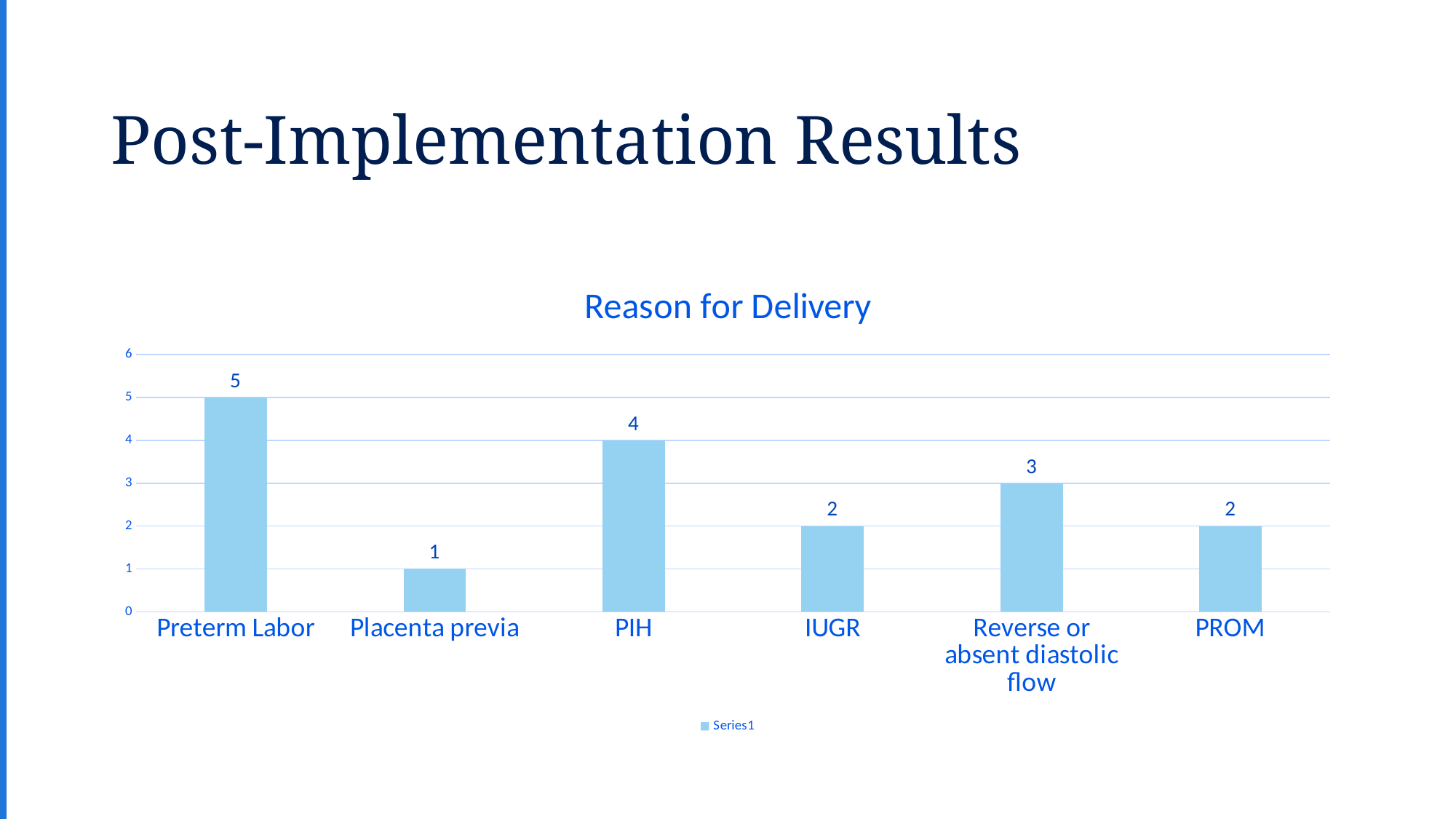
What is the difference between the values for PIH and IUGR? 2 What is the difference between the values for Preterm Labor and Placenta previa? 4 What is the value for Reverse or absent diastolic flow? 3 Which is larger, the value for PIH or the value for Reverse or absent diastolic flow? PIH What is the title of the chart? Reason for Delivery What kind of chart is shown on the slide? Bar chart What is the value for PIH in the Reason for Delivery chart? 4 What is the value for Preterm Labor in the Reason for Delivery chart? 5 Which reason for delivery has the lowest value? Placenta previa How many series does the legend list? 1 How many categories are shown in the Reason for Delivery chart? 6 Which reason for delivery has the highest value? Preterm Labor